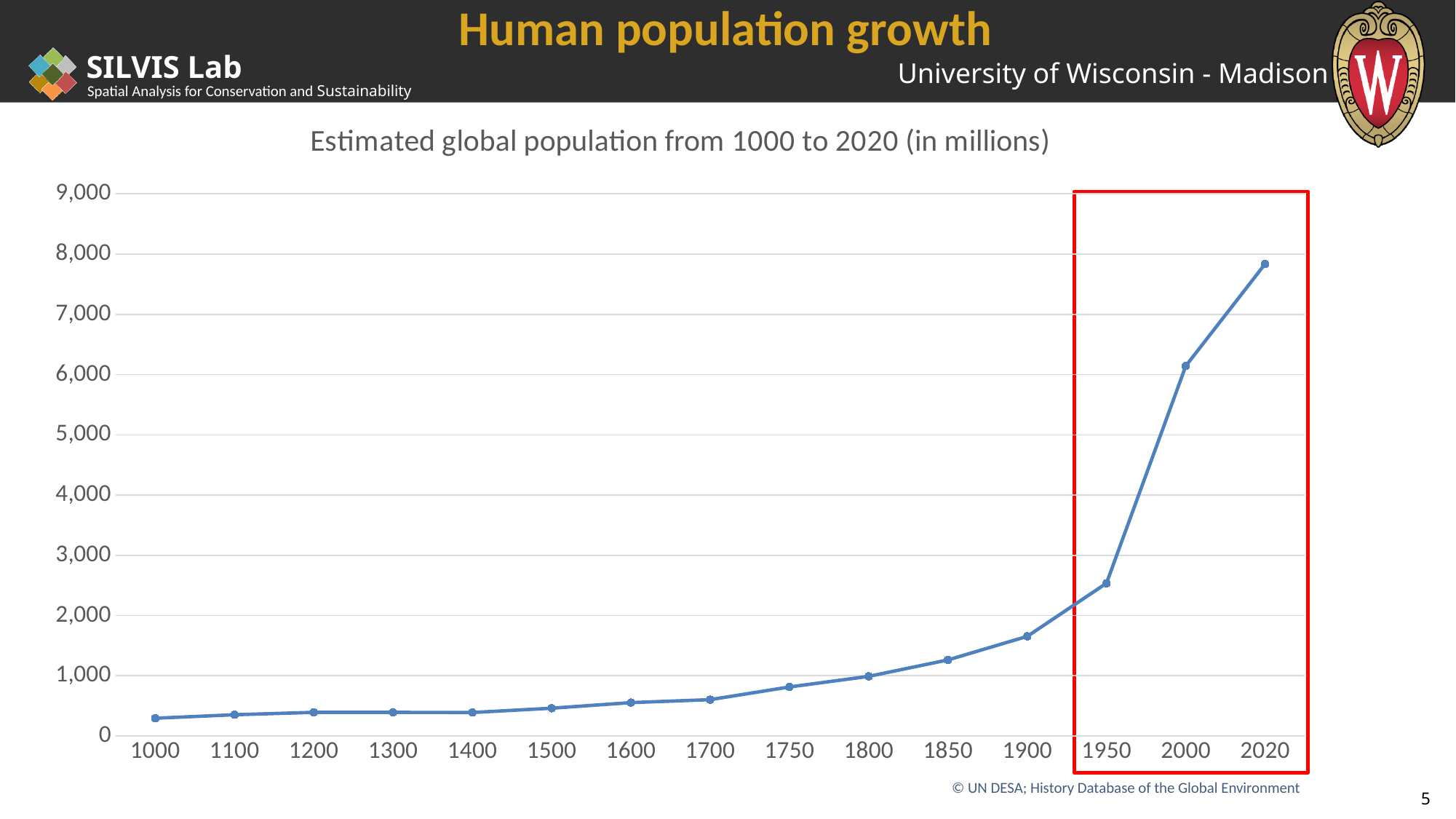
Is the value for 1700 greater or less than 1,000? less Which year has a larger estimated population, 1950 or 2000? 2000 Which year has the highest estimated global population? 2020 How many data points are plotted on the chart? 15 Does the estimated global population rise or fall from 1000 to 2020? Rise Is the value for 1950 greater or less than 2,000? greater What is the title of the chart? Estimated global population from 1000 to 2020 (in millions) What kind of chart is shown on the slide? Line chart Is the value for 1900 greater or less than 2,000? less Which year has the lowest estimated global population? 1000